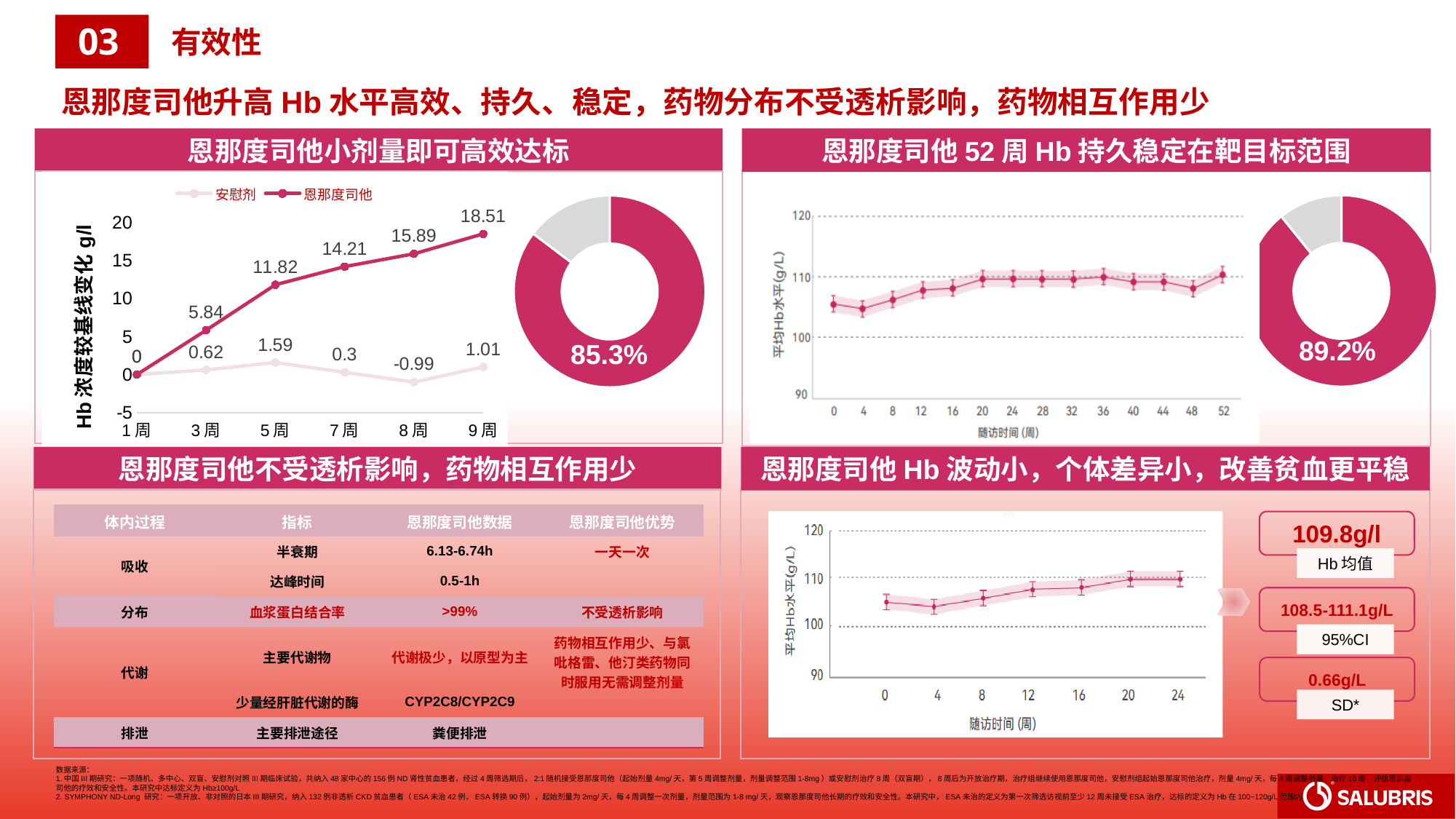
In the chart titled 恩那度司他小剂量即可高效达标, what is the value for 恩那度司他 at 9 周? 18.51 In the chart titled 恩那度司他小剂量即可高效达标, how many series does the legend list? 2 In the chart titled 恩那度司他小剂量即可高效达标, does the 恩那度司他 series rise or fall from 1 周 to 9 周? rise In the chart titled 恩那度司他小剂量即可高效达标, what is the value for 恩那度司他 at 5 周? 11.82 In the chart titled 恩那度司他小剂量即可高效达标, at which week is the 恩那度司他 value highest? 9 周 What percentage is shown in the donut chart next to the chart titled 恩那度司他小剂量即可高效达标? 85.3% In the chart titled 恩那度司他小剂量即可高效达标, what is the value for 安慰剂 at 8 周? -0.99 What percentage is shown in the donut chart next to the chart titled 恩那度司他 52 周 Hb 持久稳定在靶目标范围? 89.2% In the chart titled 恩那度司他小剂量即可高效达标, at which week is the 安慰剂 value lowest? 8 周 In the chart titled 恩那度司他 52 周 Hb 持久稳定在靶目标范围, is the mean Hb value at week 0 greater or less than 110? less In the chart titled 恩那度司他小剂量即可高效达标, what is the difference between the 恩那度司他 and 安慰剂 values at 9 周? 17.5 In the chart titled 恩那度司他小剂量即可高效达标, how many time points are shown on the x axis? 6